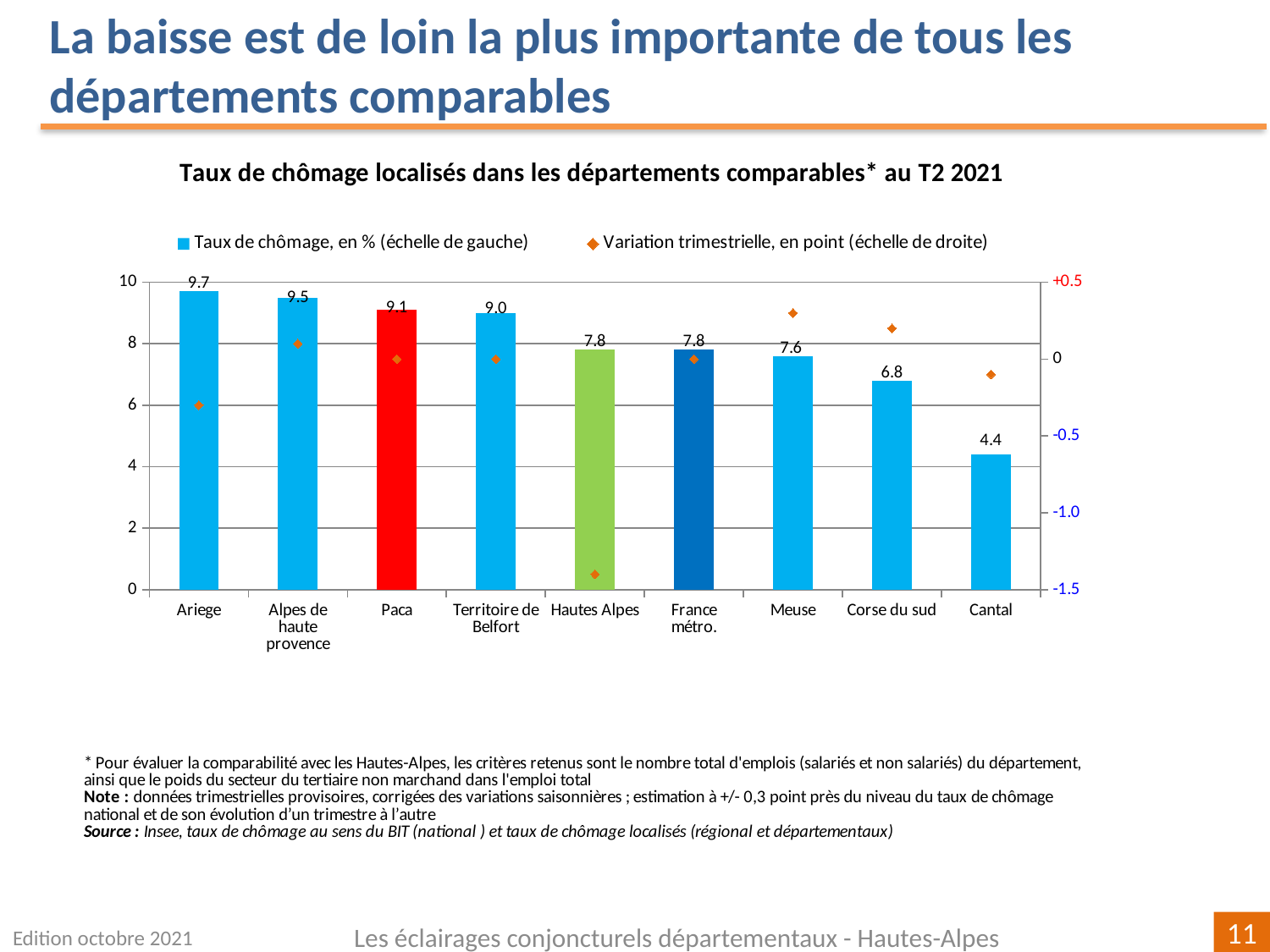
Which has a higher unemployment rate, Paca or Meuse? Paca What is the unemployment rate shown for Cantal? 4.4 Which category has the highest unemployment rate bar? Ariege Is the quarterly variation (right scale) for Meuse greater or less than 0? greater Is the quarterly variation (right scale) for Hautes Alpes greater or less than -1.0? less What is the unemployment rate shown for Hautes Alpes? 7.8 What type of chart is used to show the unemployment rates? bar chart What is the difference between the unemployment rates of Ariege and Cantal? 5.3 How many series does the legend list? 2 What is the unemployment rate shown for Ariege? 9.7 Which category has the lowest unemployment rate bar? Cantal How many categories are shown on the x axis? 9